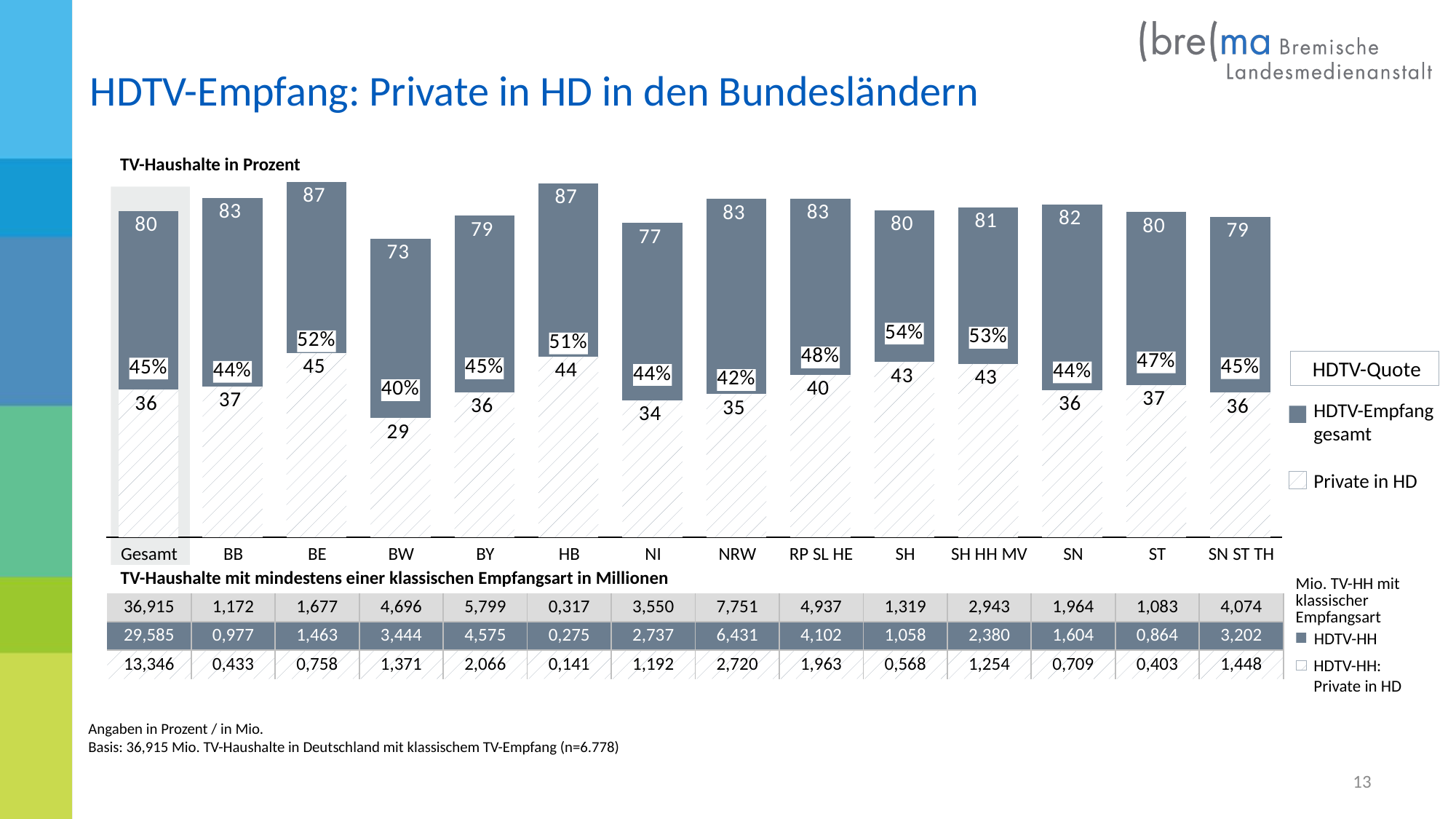
How many series does the chart legend list? 3 Which category has the lowest Private in HD value? BW How many categories are shown on the x axis of the chart? 14 What is the Private in HD value for HB? 44 What is the HDTV-Empfang gesamt value for BW? 73 Which has the larger HDTV-Empfang gesamt value, BW or BY? BY Which category has the highest Private in HD value? BE What is the difference between the HDTV-Empfang gesamt value and the Private in HD value for BE? 42 What is the HDTV-Quote shown for Gesamt? 45% What HDTV-Quote is shown for SH? 54% What kind of chart is shown on the slide? Bar chart Which category has the lowest HDTV-Empfang gesamt value? BW